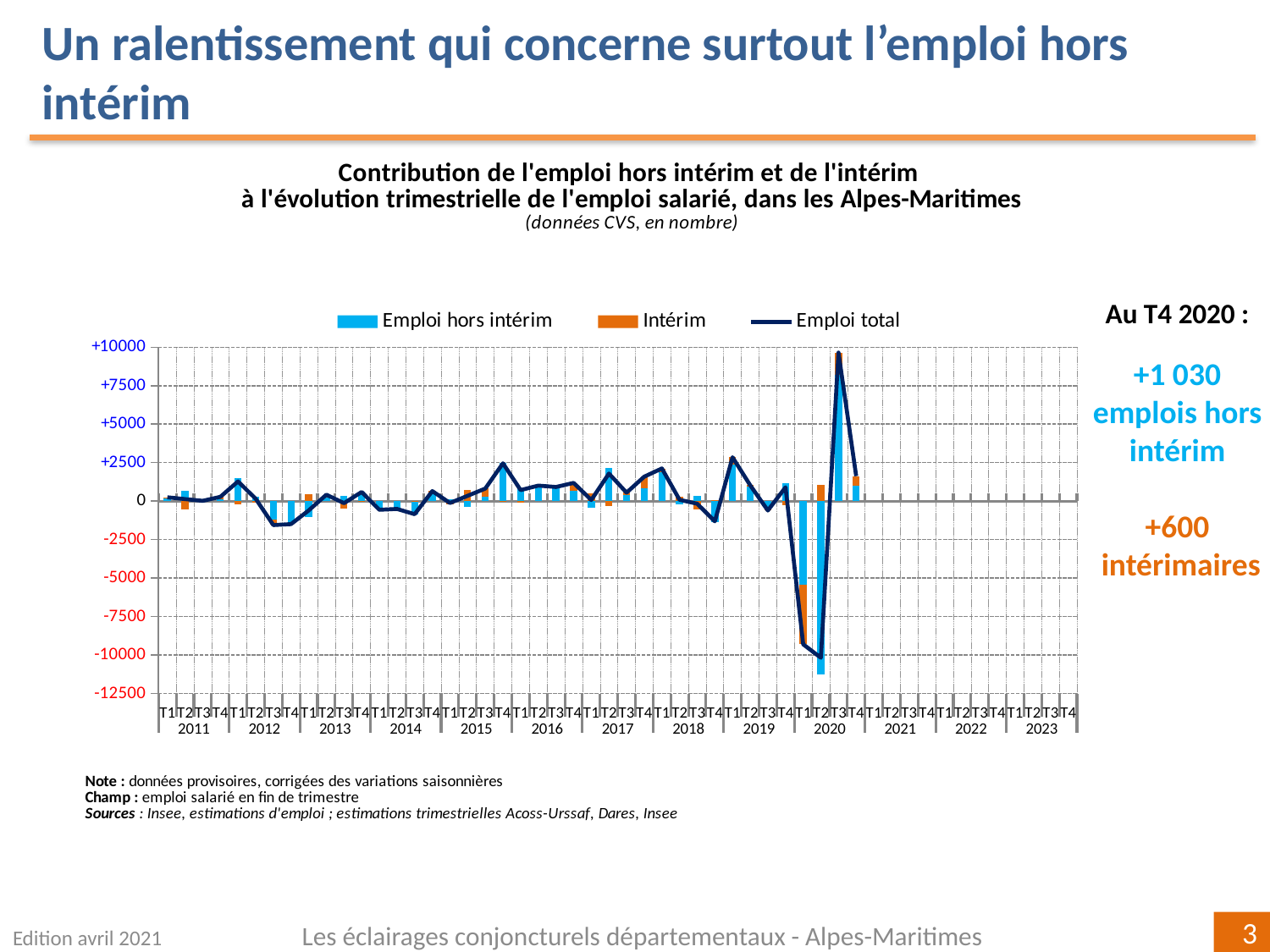
How many series does the chart legend list? 3 Is the value of 'Emploi total' at T3 2020 greater or less than +7500? greater Does the 'Emploi total' line rise or fall between T2 2020 and T3 2020? Rise What colour represents the 'Intérim' series in the chart? Orange According to the slide, what is the value for 'Emploi hors intérim' at T4 2020? +1 030 In which quarter does the 'Emploi total' line reach its lowest value? T2 2020 In which quarter does the 'Emploi total' line reach its highest value? T3 2020 What kind of chart is used to show the contribution of employment in the Alpes-Maritimes? A bar chart combined with a line Is the value of 'Emploi total' at T1 2020 greater or less than -7500? less Which is larger: 'Emploi total' at T3 2020 or 'Emploi total' at T1 2016? T3 2020 According to the slide, what is the value for 'Intérim' at T4 2020? +600 Is the value of 'Emploi hors intérim' at T2 2020 greater or less than -10000? less